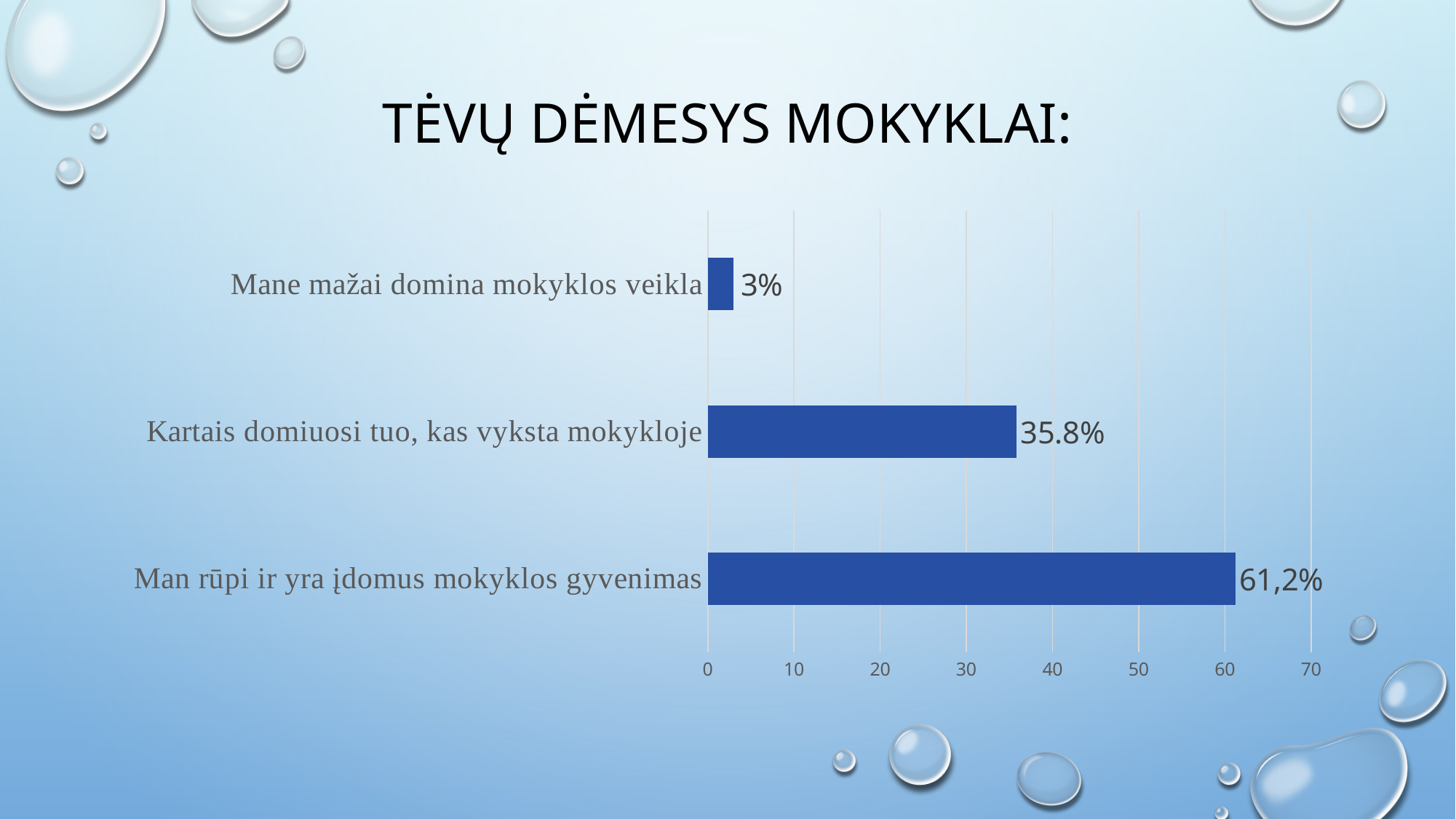
Which category has the highest value? Man rūpi ir yra įdomus mokyklos gyvenimas What is the value for "Mane mažai domina mokyklos veikla"? 3% Which is larger: the value for "Kartais domiuosi tuo, kas vyksta mokykloje" or for "Mane mažai domina mokyklos veikla"? Kartais domiuosi tuo, kas vyksta mokykloje Which category has the lowest value? Mane mažai domina mokyklos veikla What is the title of the slide? TĖVŲ DĖMESYS MOKYKLAI: Is the value for "Man rūpi ir yra įdomus mokyklos gyvenimas" greater or less than 50? greater How many categories are shown in the chart? 3 What is the difference between the values for "Man rūpi ir yra įdomus mokyklos gyvenimas" and "Kartais domiuosi tuo, kas vyksta mokykloje"? 25.4% What kind of chart is shown on the slide? bar chart What is the difference between the values for "Kartais domiuosi tuo, kas vyksta mokykloje" and "Mane mažai domina mokyklos veikla"? 32.8% What is the value for "Kartais domiuosi tuo, kas vyksta mokykloje"? 35.8% What is the value for "Man rūpi ir yra įdomus mokyklos gyvenimas"? 61,2%